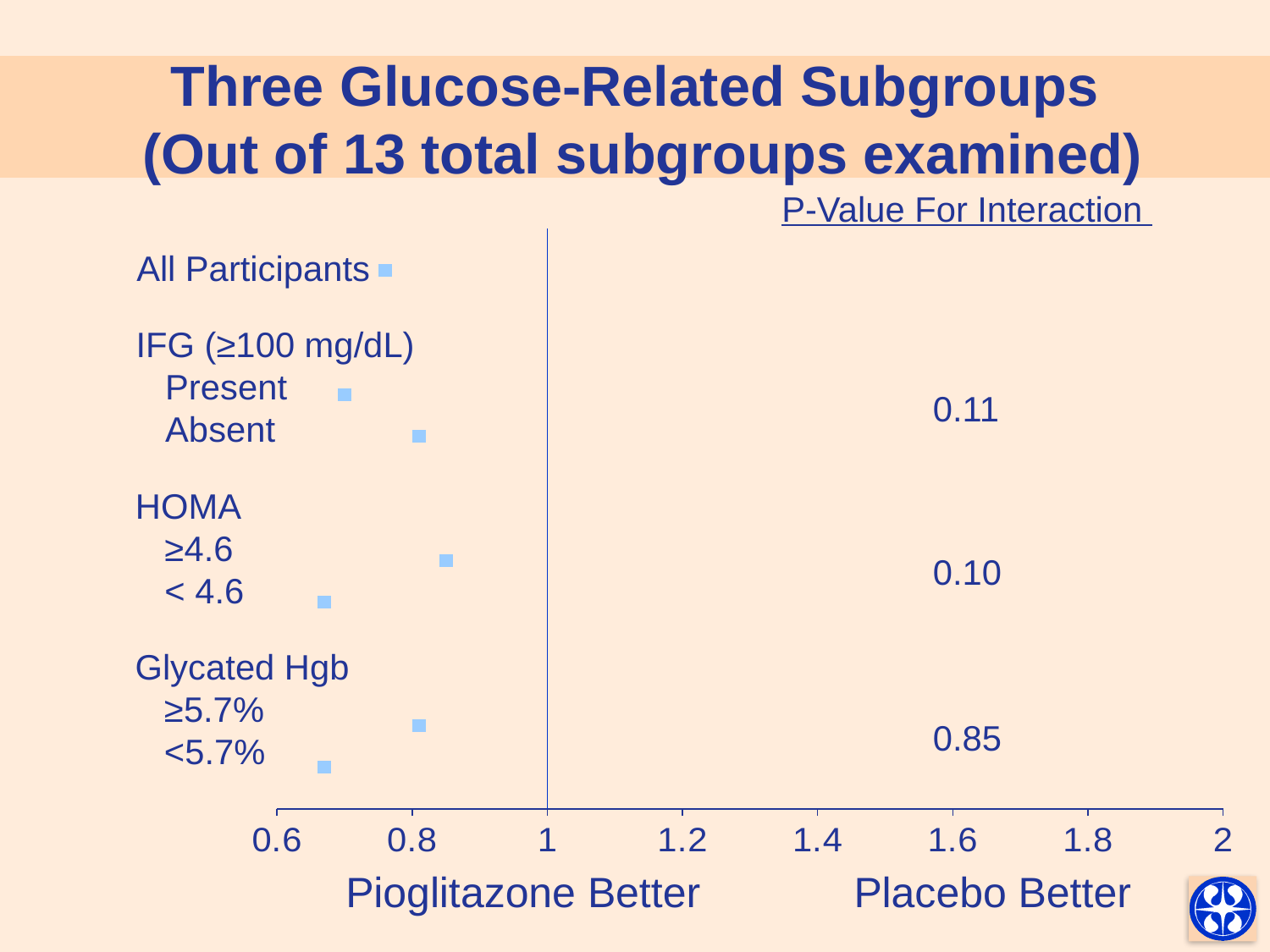
How many data points are plotted on the chart? 7 Is the value for HOMA < 4.6 greater or less than 0.8? less What is the P-value for interaction shown for the Glycated Hgb subgroup? 0.85 Which side of the x axis is labelled 'Placebo Better'? The right side (values above 1) What is the P-value for interaction shown for the IFG (≥100 mg/dL) subgroup? 0.11 What is the P-value for interaction shown for the HOMA subgroup? 0.10 Which has the larger value, Glycated Hgb ≥5.7% or Glycated Hgb <5.7%? Glycated Hgb ≥5.7% Is the value for HOMA ≥4.6 greater or less than 0.8? greater Which has the larger value, HOMA ≥4.6 or HOMA < 4.6? HOMA ≥4.6 Is the value for IFG Present greater or less than 0.8? less Which has the larger value, IFG Present or IFG Absent? IFG Absent